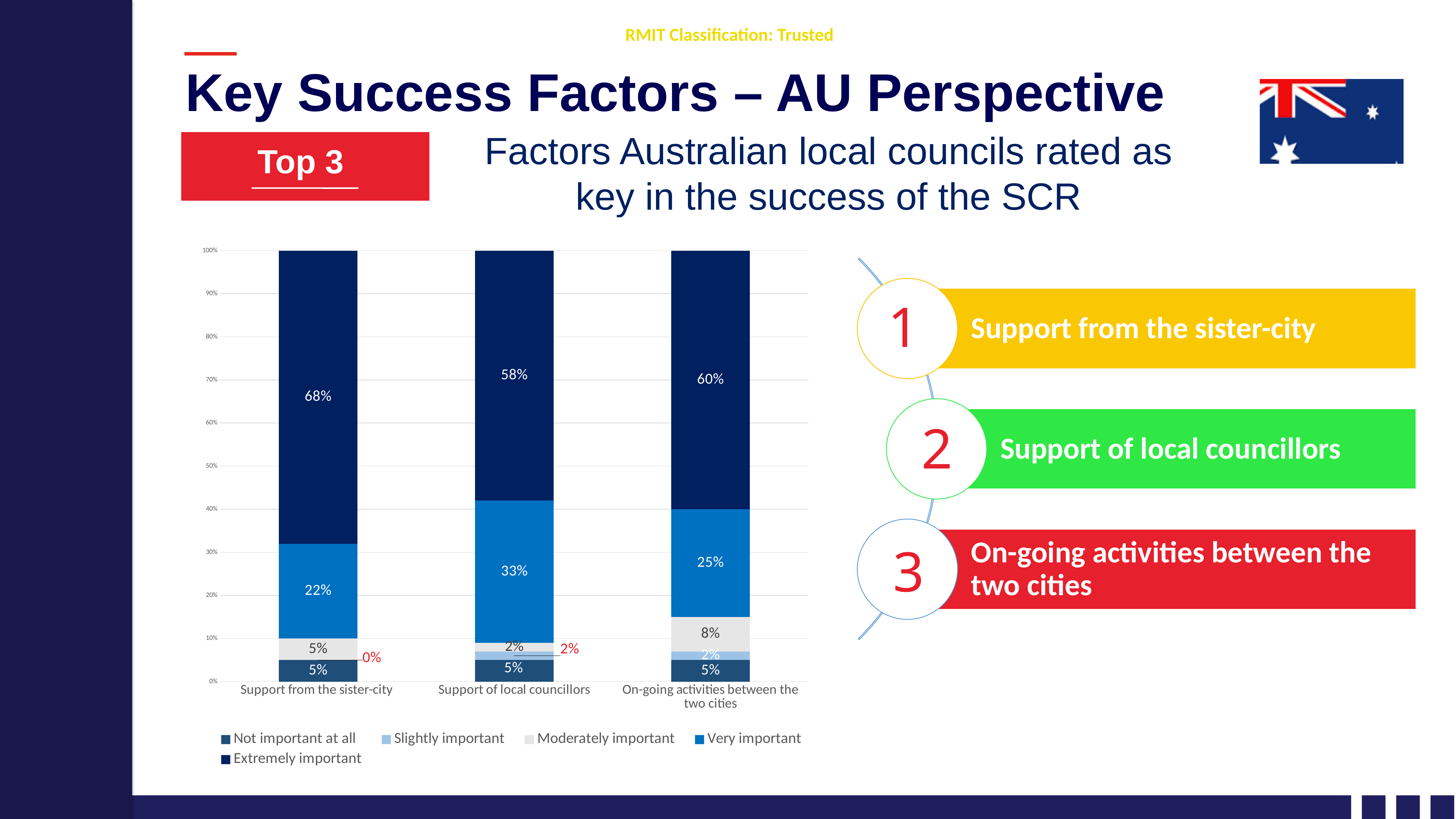
What percentage of councils rated 'Support of local councillors' as Very important? 33% How many factors (categories) are shown on the x axis of the chart? 3 Which factor has the highest share of 'Extremely important' ratings? Support from the sister-city What percentage of councils rated 'Support from the sister-city' as Extremely important? 68% Which legend entry is shown in the darkest navy colour at the top of each bar? Extremely important How many series does the chart legend list? 5 What is the difference between the 'Extremely important' shares for 'Support from the sister-city' and 'Support of local councillors'? 10% What percentage of councils rated 'On-going activities between the two cities' as Moderately important? 8% Which is larger: the 'Very important' share for 'On-going activities between the two cities' or for 'Support of local councillors'? Support of local councillors Which factor has the lowest share of 'Very important' ratings? Support from the sister-city What kind of chart is shown on the slide? Stacked bar chart What percentage of councils rated 'Support from the sister-city' as Slightly important? 0%